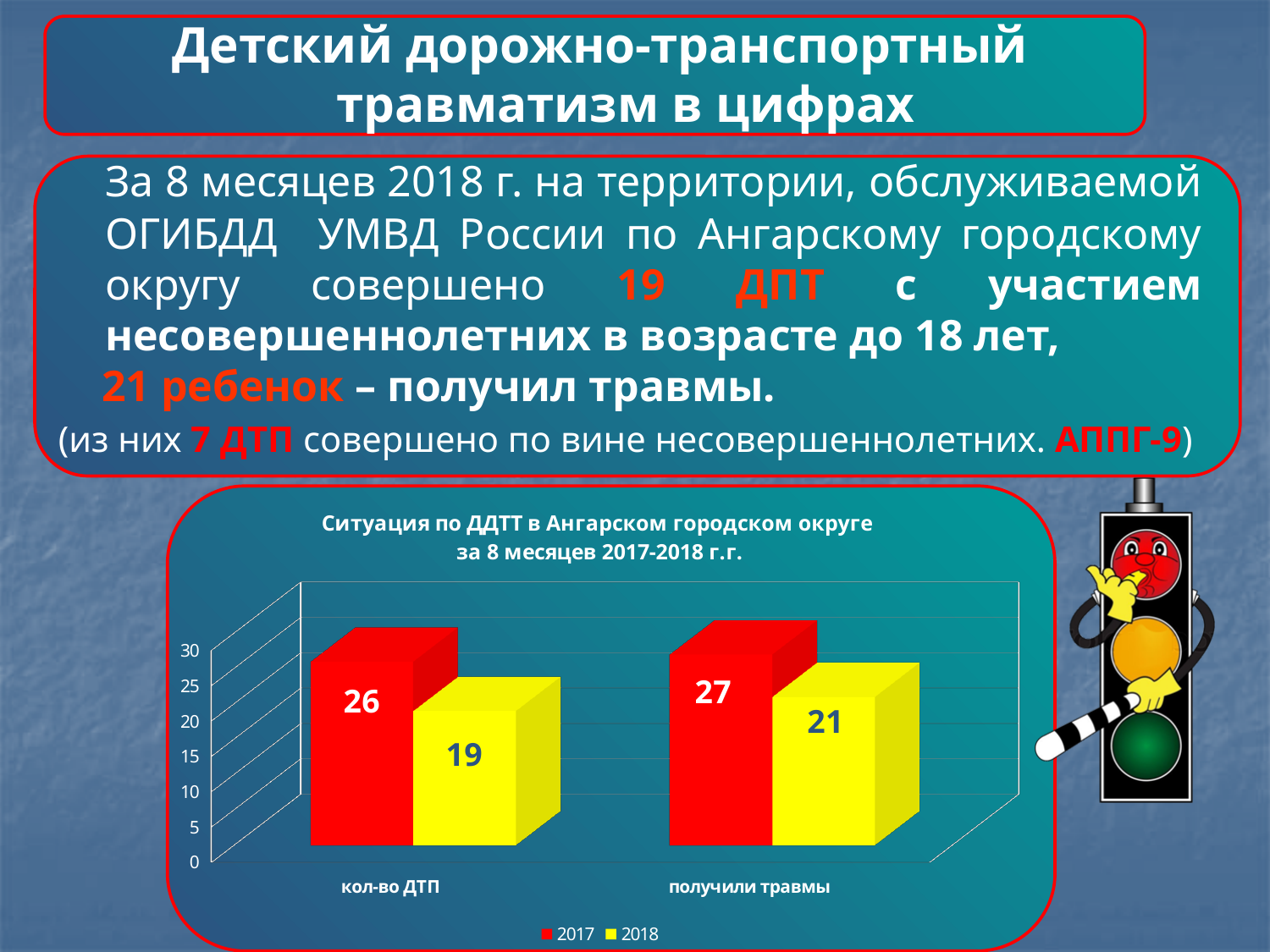
What is the value for 2017 in the 'кол-во ДТП' category? 26 Which colour represents the 2018 series in the chart? yellow What kind of chart is shown on the slide? bar chart What is the value for 2018 in the 'получили травмы' category? 21 What is the value for 2018 in the 'кол-во ДТП' category? 19 How many series does the chart legend list? 2 Which category has the highest value for the 2017 series? получили травмы How many categories are shown on the x axis of the chart? 2 Which category has the lowest value for the 2018 series? кол-во ДТП What is the value for 2017 in the 'получили травмы' category? 27 What is the difference between the 2017 and 2018 values for 'кол-во ДТП'? 7 Which is larger in the 'получили травмы' category: the 2017 value or the 2018 value? 2017